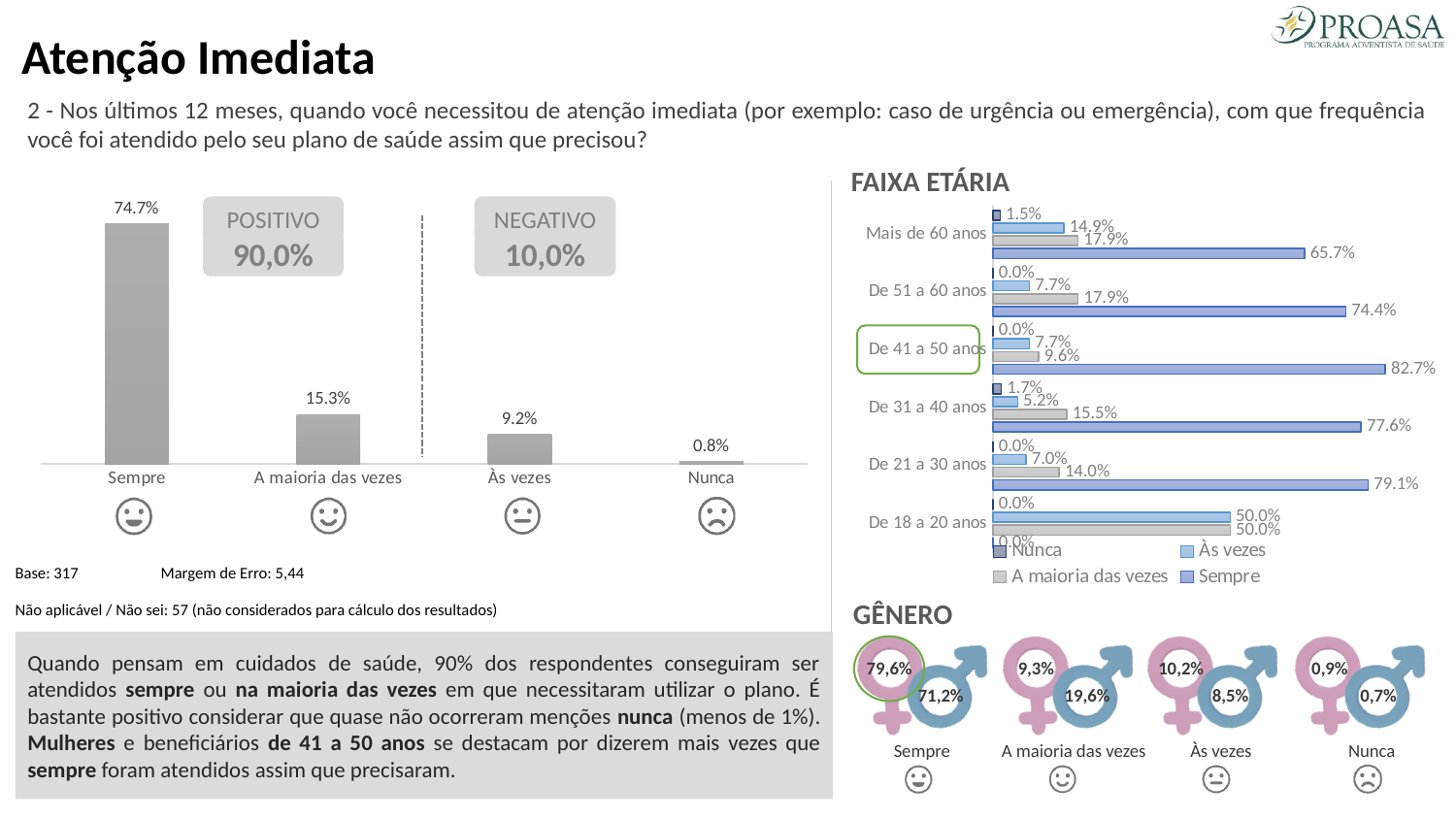
In the FAIXA ETÁRIA chart, how many age groups are shown? 6 In the FAIXA ETÁRIA chart, what is the 'Sempre' value for 'De 41 a 50 anos'? 82.7% In the left bar chart, what is the difference between 'A maioria das vezes' and 'Às vezes'? 6.1% In the left bar chart, how many categories are shown? 4 In the FAIXA ETÁRIA chart, how many series does the legend list? 4 In the left bar chart, which category has the highest value? Sempre In the FAIXA ETÁRIA chart, which age group has the lowest 'Sempre' value among groups with a non-zero 'Sempre' value? Mais de 60 anos In the FAIXA ETÁRIA chart, what is the 'Às vezes' value for 'Mais de 60 anos'? 14.9% What kind of chart is the left chart? Bar chart In the left bar chart, what is the value for 'Sempre'? 74.7% In the left bar chart, what is the value for 'Nunca'? 0.8% In the FAIXA ETÁRIA chart, is the 'Sempre' value for 'De 51 a 60 anos' larger or smaller than for 'De 31 a 40 anos'? Smaller